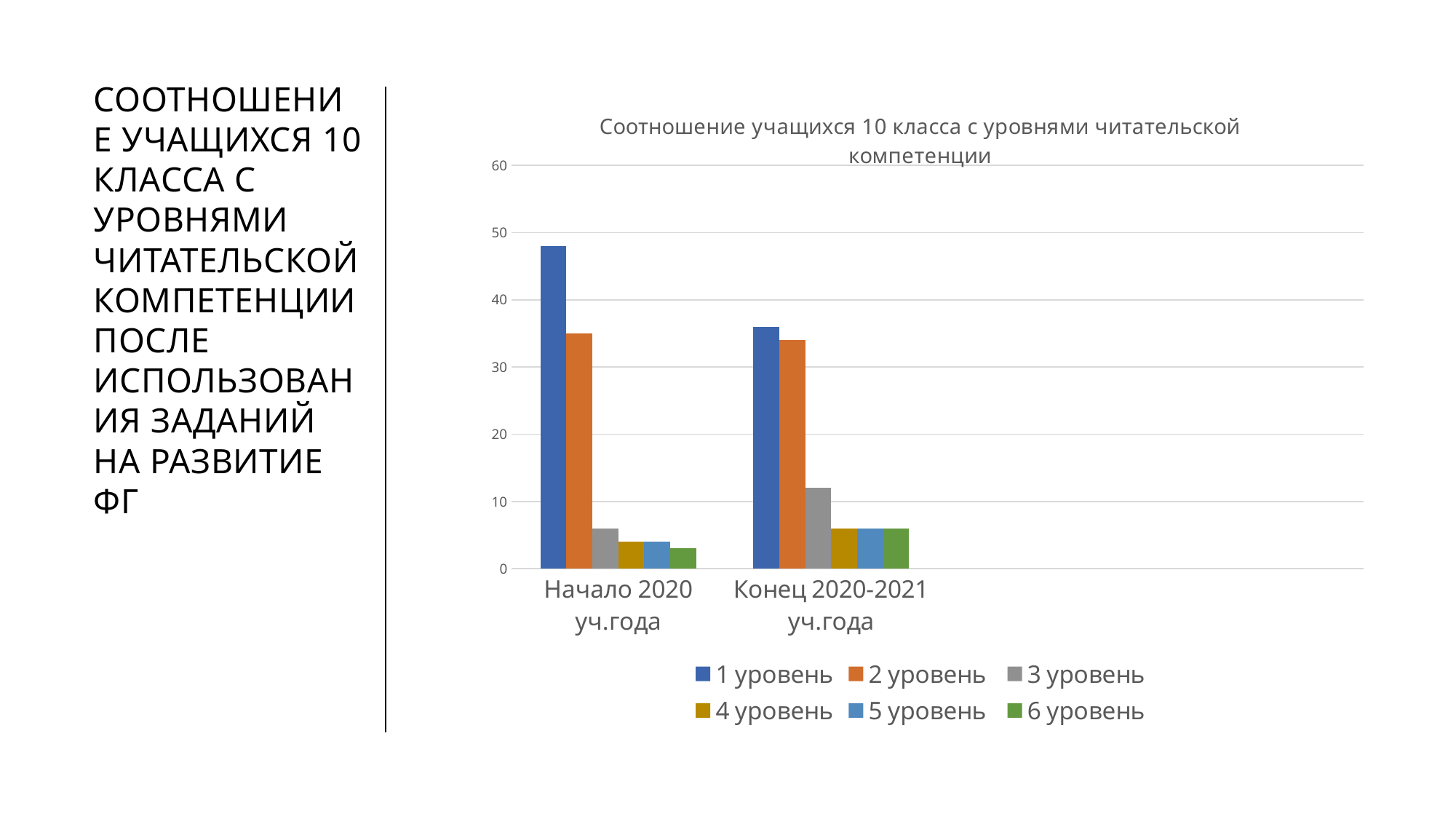
Is the value for 1 уровень at Конец 2020-2021 уч.года greater or less than 40? less How many categories are shown on the x axis? 2 Is the value for 3 уровень at Конец 2020-2021 уч.года greater or less than 10? greater How many series does the legend list? 6 Is the value for 1 уровень at Начало 2020 уч.года greater or less than 40? greater Which series has the highest value for Начало 2020 уч.года? 1 уровень Which is larger: 1 уровень at Начало 2020 уч.года or 1 уровень at Конец 2020-2021 уч.года? Начало 2020 уч.года Which series has the highest value for Конец 2020-2021 уч.года? 1 уровень Which series has the lowest value for Начало 2020 уч.года? 6 уровень What kind of chart is shown on the slide? bar chart Does the value for 1 уровень rise or fall from Начало 2020 уч.года to Конец 2020-2021 уч.года? fall